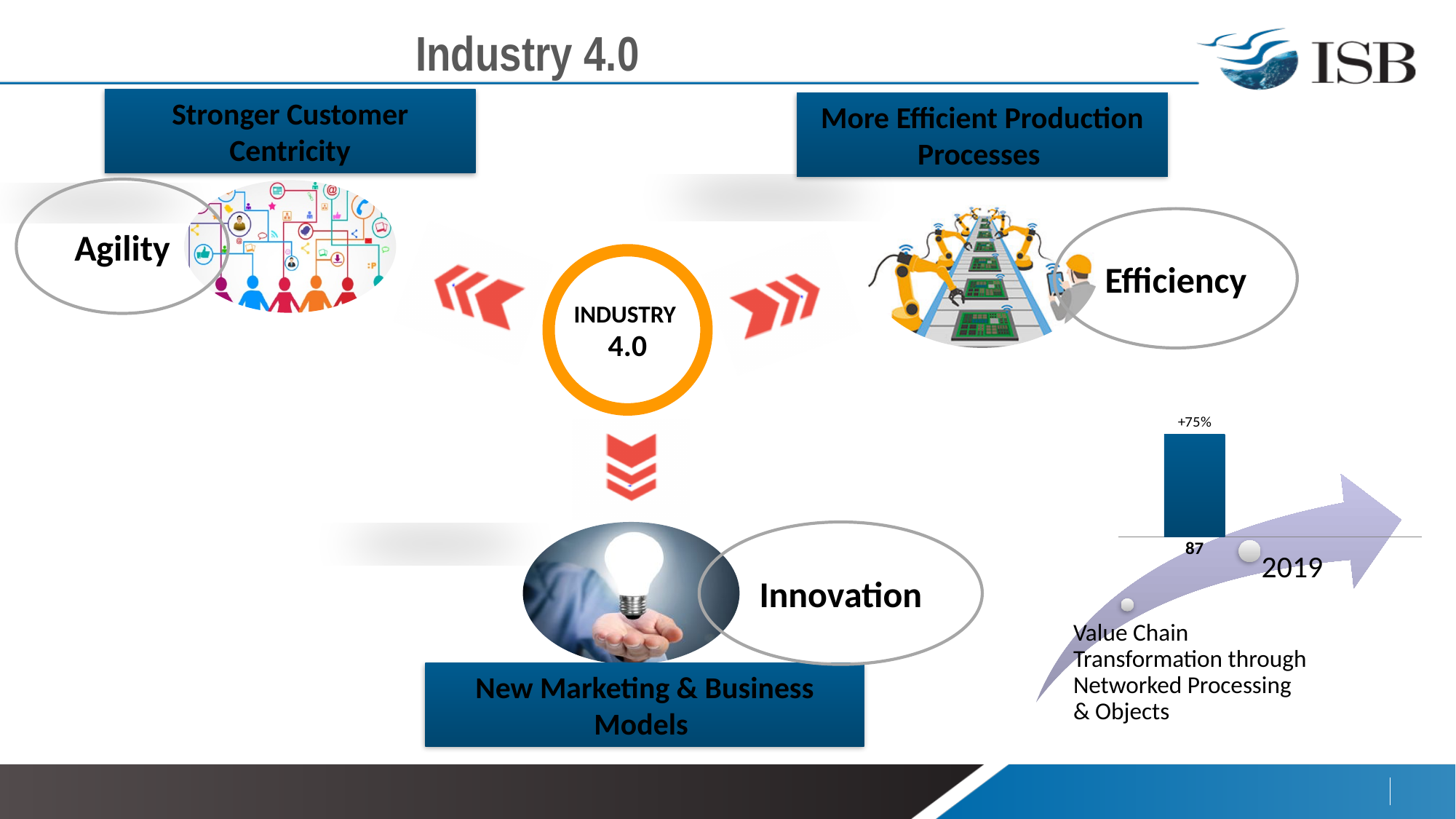
What colour is the bar in the chart at the lower right of the slide? dark blue What data label is printed above the bar in the chart at the lower right of the slide? +75% What kind of chart is shown at the lower right of the slide? bar chart What category label appears below the bar in the chart at the lower right of the slide? 87 How many bars does the chart at the lower right of the slide have? 1